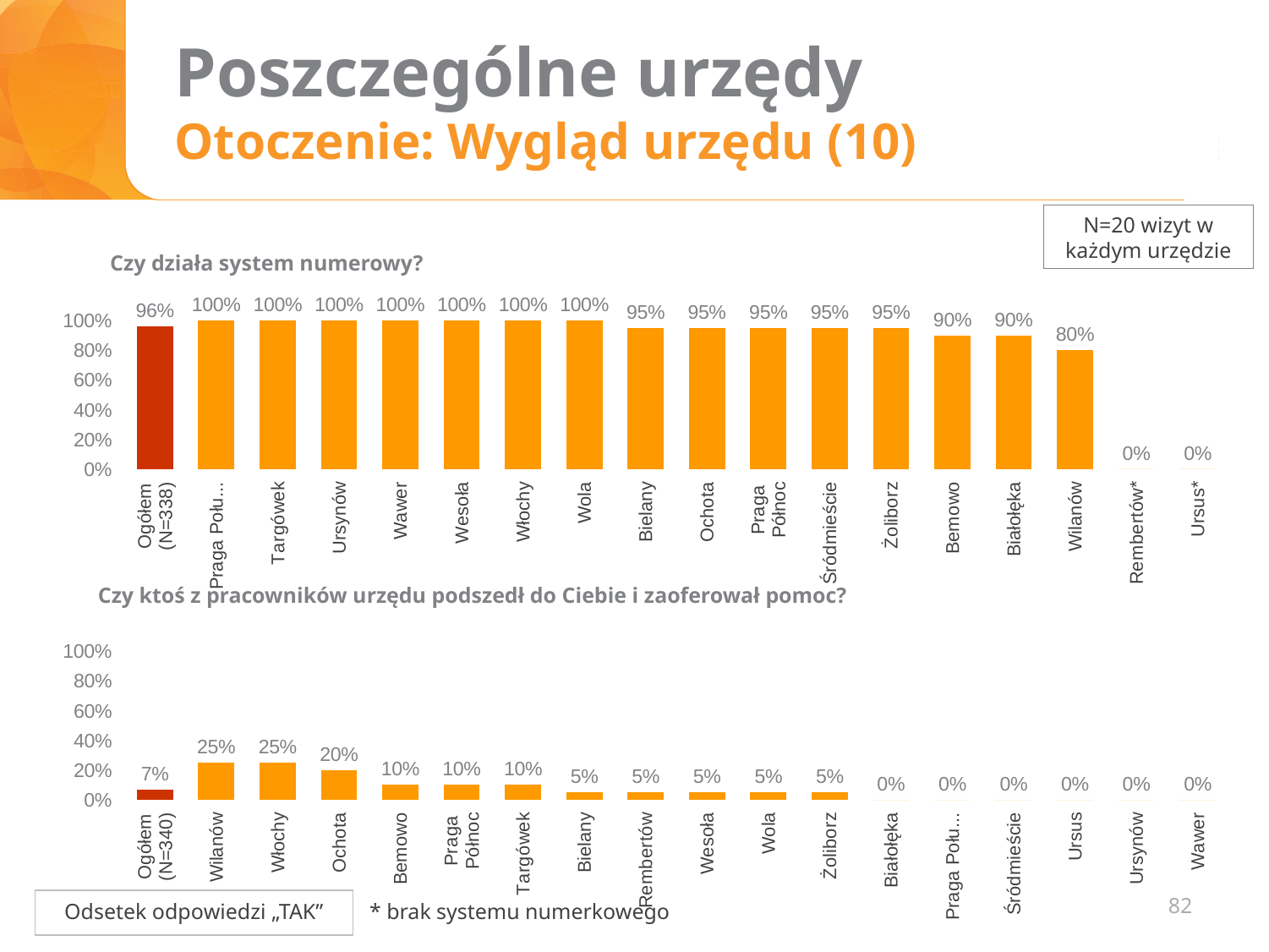
In the bottom chart 'Czy ktoś z pracowników urzędu podszedł do Ciebie i zaoferował pomoc?', what is the value for Ochota? 20% In the top chart 'Czy działa system numerowy?', what is the difference between the values for Wola and Wilanów? 20% In the top chart 'Czy działa system numerowy?', what is the value for Ogółem (N=338)? 96% In the top chart 'Czy działa system numerowy?', which is larger, the value for Bielany or the value for Białołęka? Bielany In the bottom chart 'Czy ktoś z pracowników urzędu podszedł do Ciebie i zaoferował pomoc?', which is larger, the value for Ochota or the value for Targówek? Ochota What type of chart is the bottom chart 'Czy ktoś z pracowników urzędu podszedł do Ciebie i zaoferował pomoc?'? Bar chart In the bottom chart 'Czy ktoś z pracowników urzędu podszedł do Ciebie i zaoferował pomoc?', what is the difference between the values for Wilanów and Bemowo? 15% In the top chart 'Czy działa system numerowy?', what is the value for Wilanów? 80% In the bottom chart 'Czy ktoś z pracowników urzędu podszedł do Ciebie i zaoferował pomoc?', what is the value for Ogółem (N=340)? 7% In the top chart 'Czy działa system numerowy?', what is the value for Bemowo? 90% In the bottom chart 'Czy ktoś z pracowników urzędu podszedł do Ciebie i zaoferował pomoc?', do the values rise or fall from left to right after the Ogółem bar? Fall How many categories are shown in the top chart 'Czy działa system numerowy?'? 18